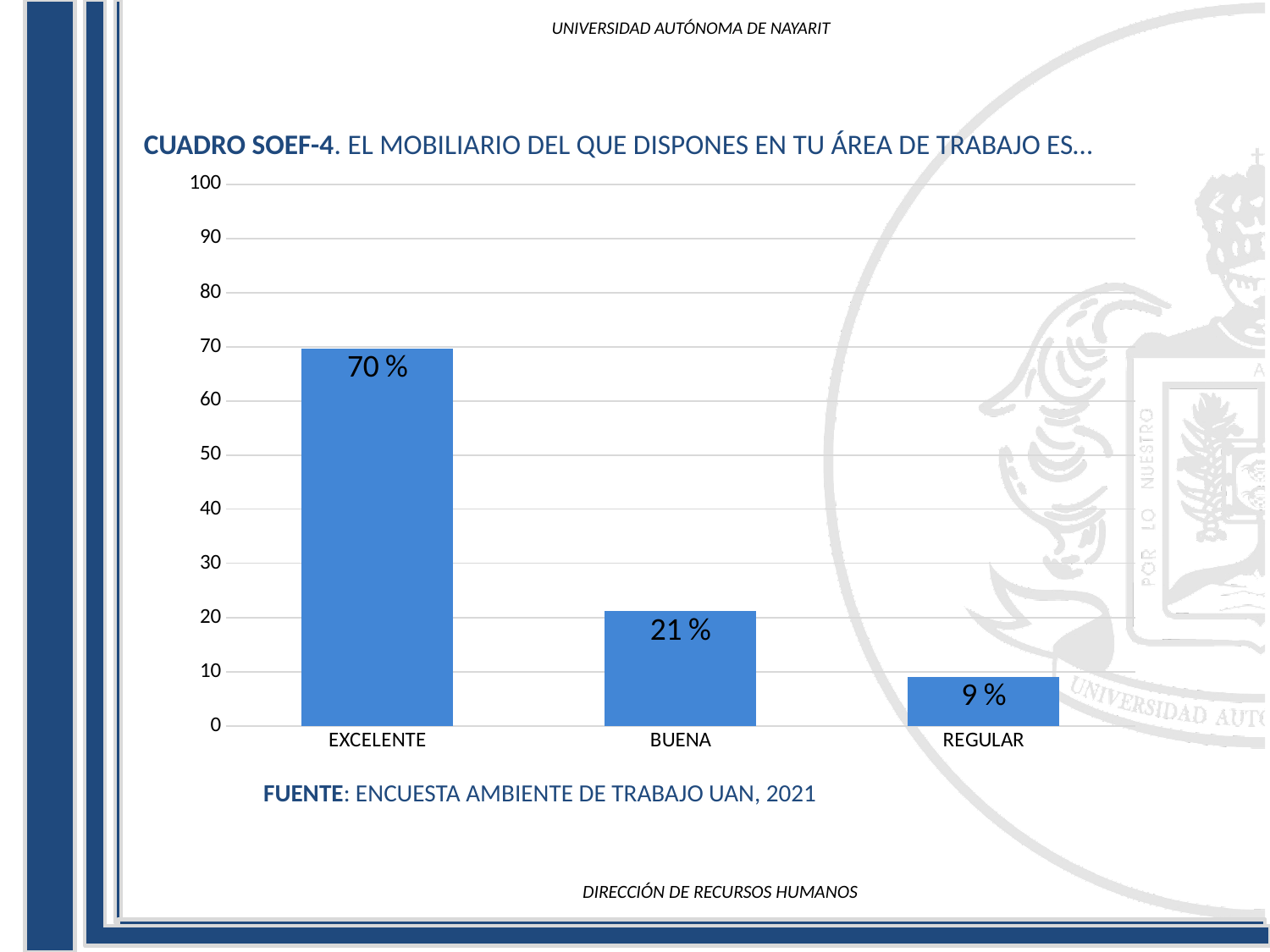
What kind of chart is shown on the slide? bar chart What is the value for EXCELENTE? 70 % Is the value for BUENA greater or less than 30? less What is the difference between the values for EXCELENTE and BUENA? 49 % Which category has the highest value? EXCELENTE How many categories are shown on the x axis? 3 Which is larger, the value for BUENA or the value for REGULAR? BUENA What is the value for REGULAR? 9 % What is the value for BUENA? 21 % What source is cited below the chart? ENCUESTA AMBIENTE DE TRABAJO UAN, 2021 What is the difference between the values for BUENA and REGULAR? 12 % Which category has the lowest value? REGULAR